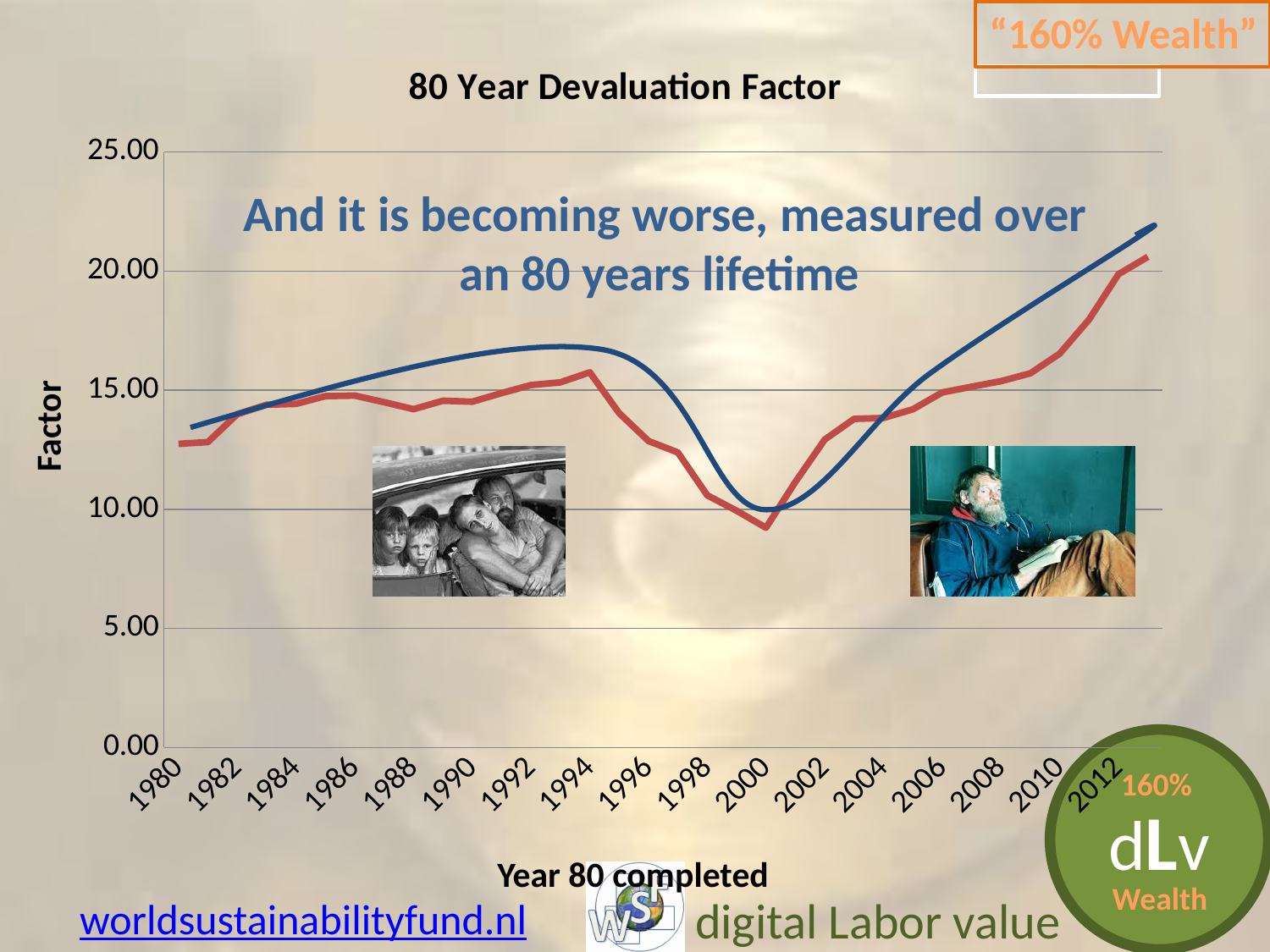
How many lines are plotted on the chart? 2 In which year does the red line reach its lowest value? 2000 What is the label on the vertical axis of the chart? Factor Is the value of the red line in 1980 greater or less than 15.00? less How many year labels are shown along the x axis? 17 Do the lines rise or fall between 2000 and 2012? rise Is the value of the red line in 2000 greater or less than 10.00? less Is the value of the blue line in 2012 greater or less than 20.00? greater What kind of chart is shown on the slide? line chart What is the title of the chart? 80 Year Devaluation Factor